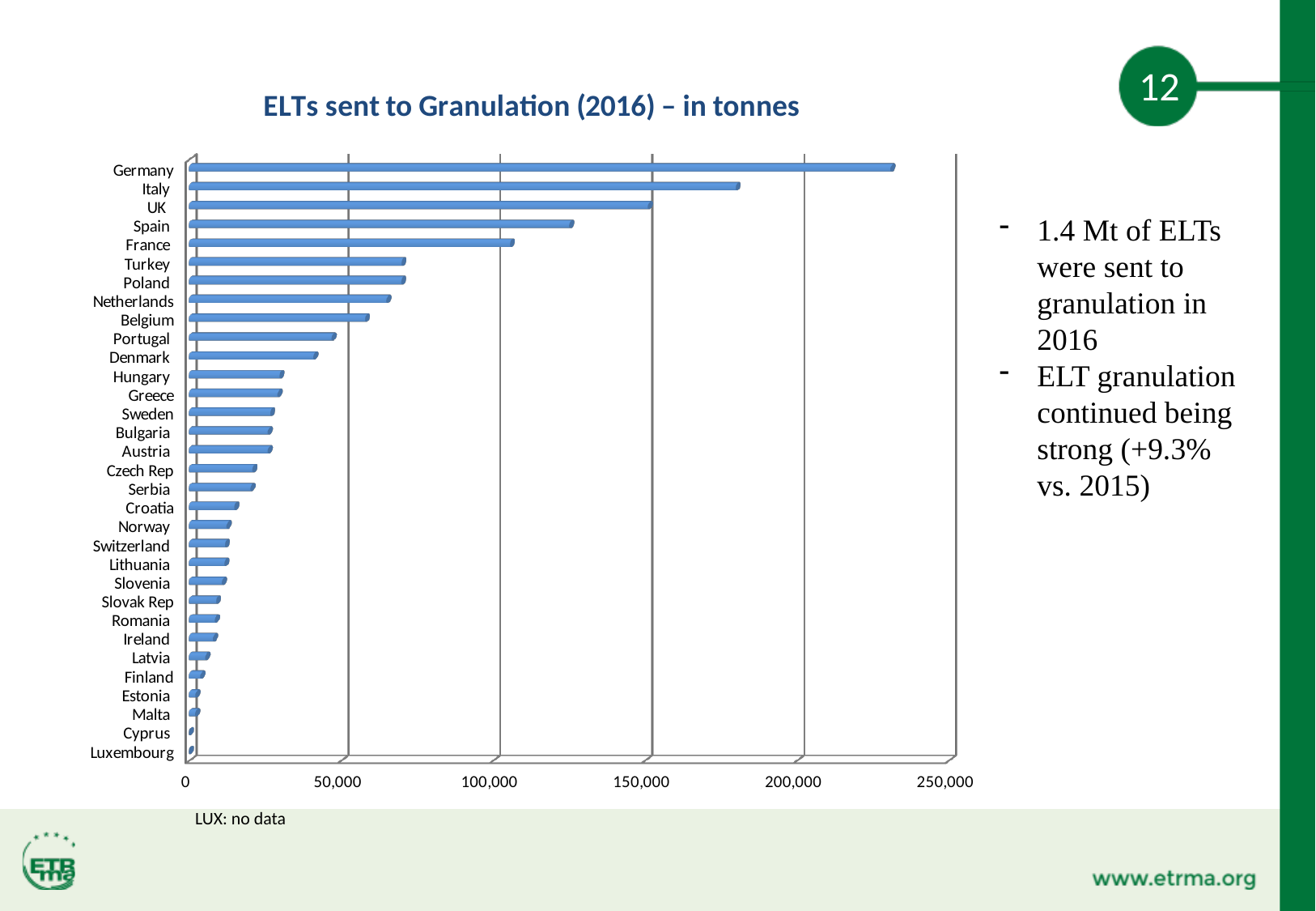
Which country is noted on the slide as having no data? Luxembourg Which has a larger value, Italy or the UK? Italy Is the value for Denmark greater or less than 50,000? less What is the title of the chart? ELTs sent to Granulation (2016) – in tonnes Which has a larger value, Spain or France? Spain Is the value for Spain greater or less than 100,000? greater Which country has the highest value for ELTs sent to granulation? Germany Is the value for Germany greater or less than 200,000? greater What kind of chart is shown on the slide? bar chart How many countries are listed on the chart? 32